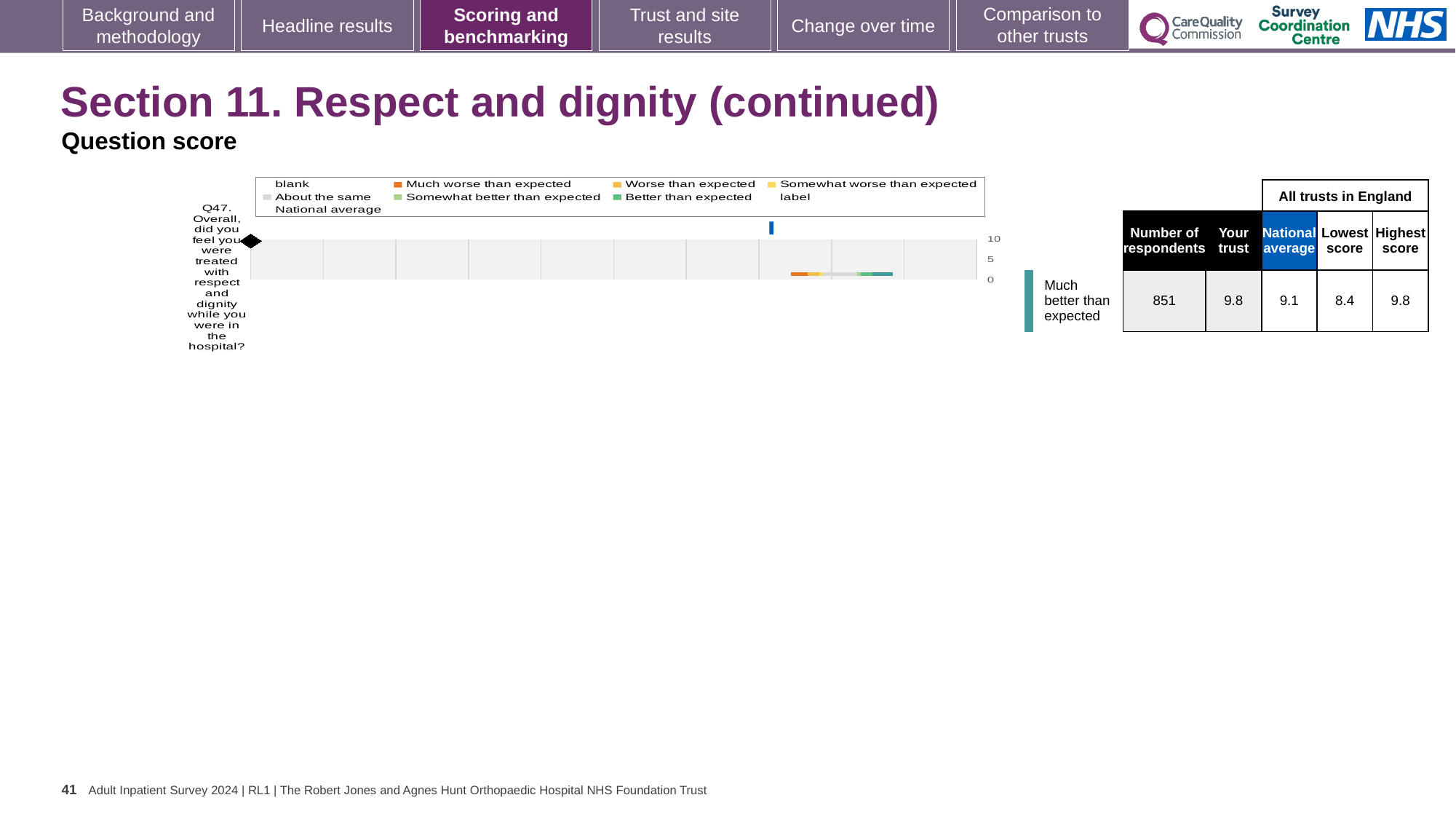
What is the difference between the Your trust score and the National average score? 0.7 What is the highest tick value shown on the chart's axis? 10 How many entries does the chart legend list? 9 In the table next to the chart, what is the number of respondents for Q47? 851 In the table next to the chart, what is the score for Your trust? 9.8 Which is larger, the Your trust score or the National average score? Your trust Which question number is labelled on the chart? Q47 In the table next to the chart, what is the Highest score among all trusts in England? 9.8 What benchmark category is the trust's Q47 score assigned to? Much better than expected In the table next to the chart, what is the National average score? 9.1 In the table next to the chart, what is the Lowest score among all trusts in England? 8.4 What type of chart is shown on the slide? bar chart